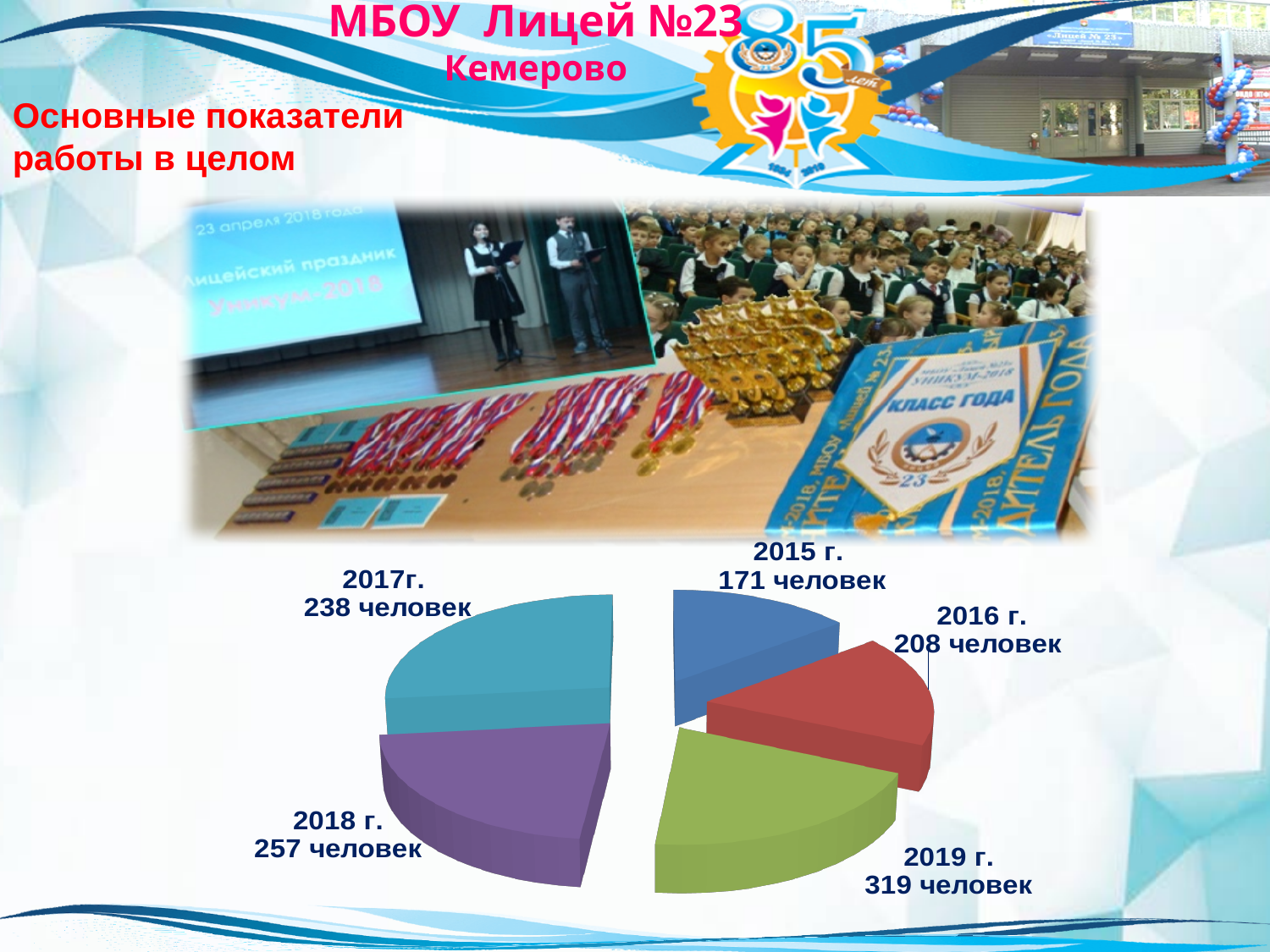
Do the values rise or fall from 2015 г. to 2019 г.? rise Which year has the smallest slice in the pie chart? 2015 г. Which year has the largest slice in the pie chart? 2019 г. What is the value shown for 2017г.? 238 человек What is the value shown for 2019 г.? 319 человек What is the value shown for 2015 г.? 171 человек How many slices does the pie chart have? 5 What is the value shown for 2018 г.? 257 человек Which is larger, the value for 2017г. or the value for 2018 г.? 2018 г. What is the value shown for 2016 г.? 208 человек What is the difference between the values for 2019 г. and 2015 г.? 148 человек What kind of chart is shown on the slide? pie chart